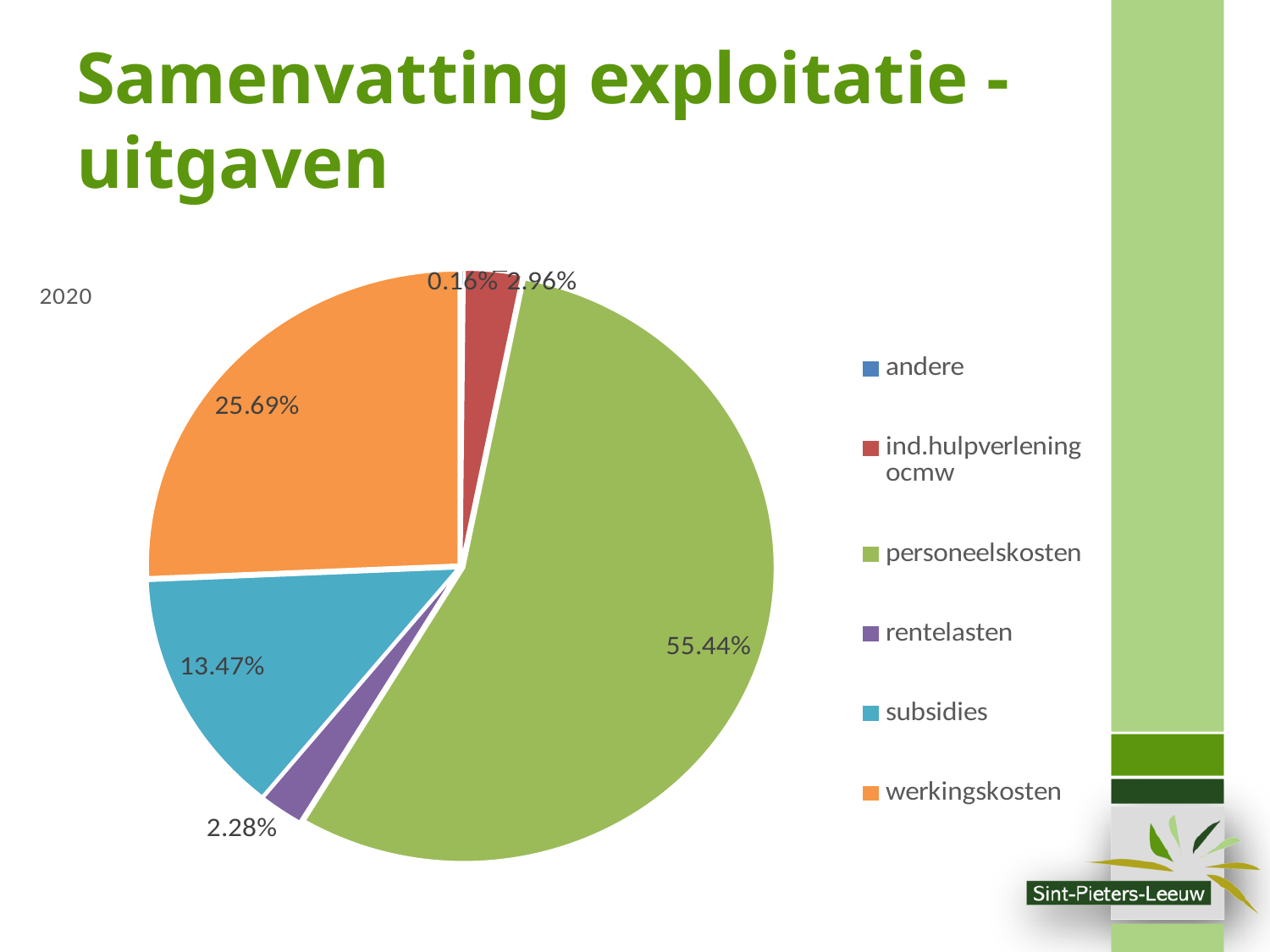
What is the value shown for ind.hulpverlening ocmw? 2.96% How many categories does the legend list? 6 What is the difference between the personeelskosten share and the werkingskosten share? 29.75 percentage points Which category has the smallest slice of the pie? andere Which category has the largest slice of the pie? personeelskosten What is the value shown for subsidies? 13.47% What share of the pie does personeelskosten represent? 55.44% What is the value shown for rentelasten? 2.28% What is the value shown for werkingskosten? 25.69% What kind of chart is shown on the slide? pie chart Which is larger, the slice for subsidies or the slice for werkingskosten? werkingskosten Which year is indicated next to the chart? 2020